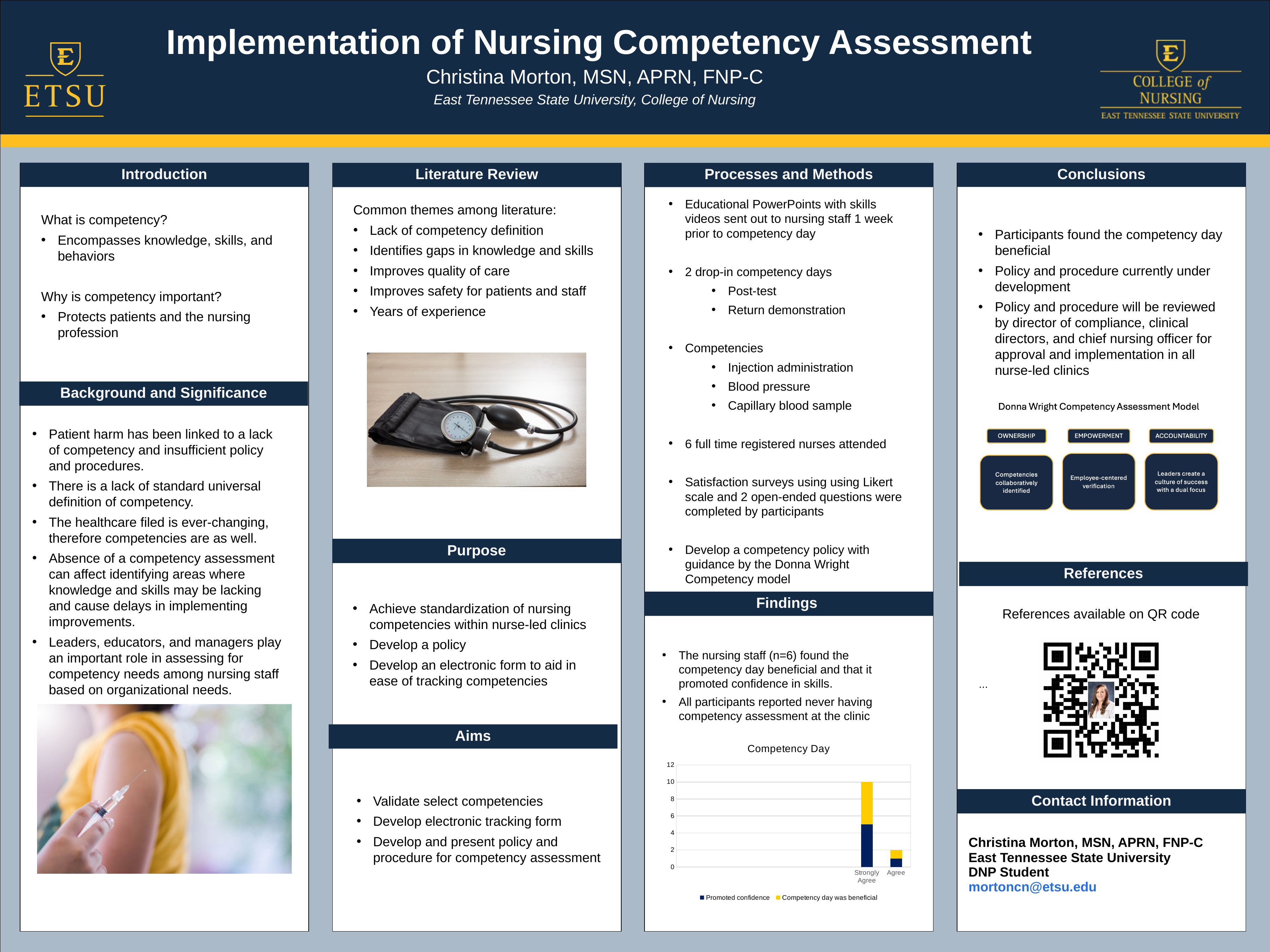
What is the total height of the stacked bar for Strongly Agree in the Competency Day chart? 10 What kind of chart is shown under the Findings section? bar chart How many series does the legend of the Competency Day chart list? 2 Which category has the tallest stacked bar in the Competency Day chart? Strongly Agree Which legend entry in the Competency Day chart is shown in yellow? Competency day was beneficial How many categories are shown on the x axis of the Competency Day chart? 2 Which category has the shortest stacked bar in the Competency Day chart? Agree In the Competency Day chart, is the total stacked bar for Strongly Agree larger or smaller than the total for Agree? larger What is the total height of the stacked bar for Agree in the Competency Day chart? 2 In the Competency Day chart, is the Promoted confidence value for Strongly Agree greater or less than 4? greater What is the title of the chart in the Findings section? Competency Day In the Competency Day chart, is the Promoted confidence value for Agree greater or less than 2? less